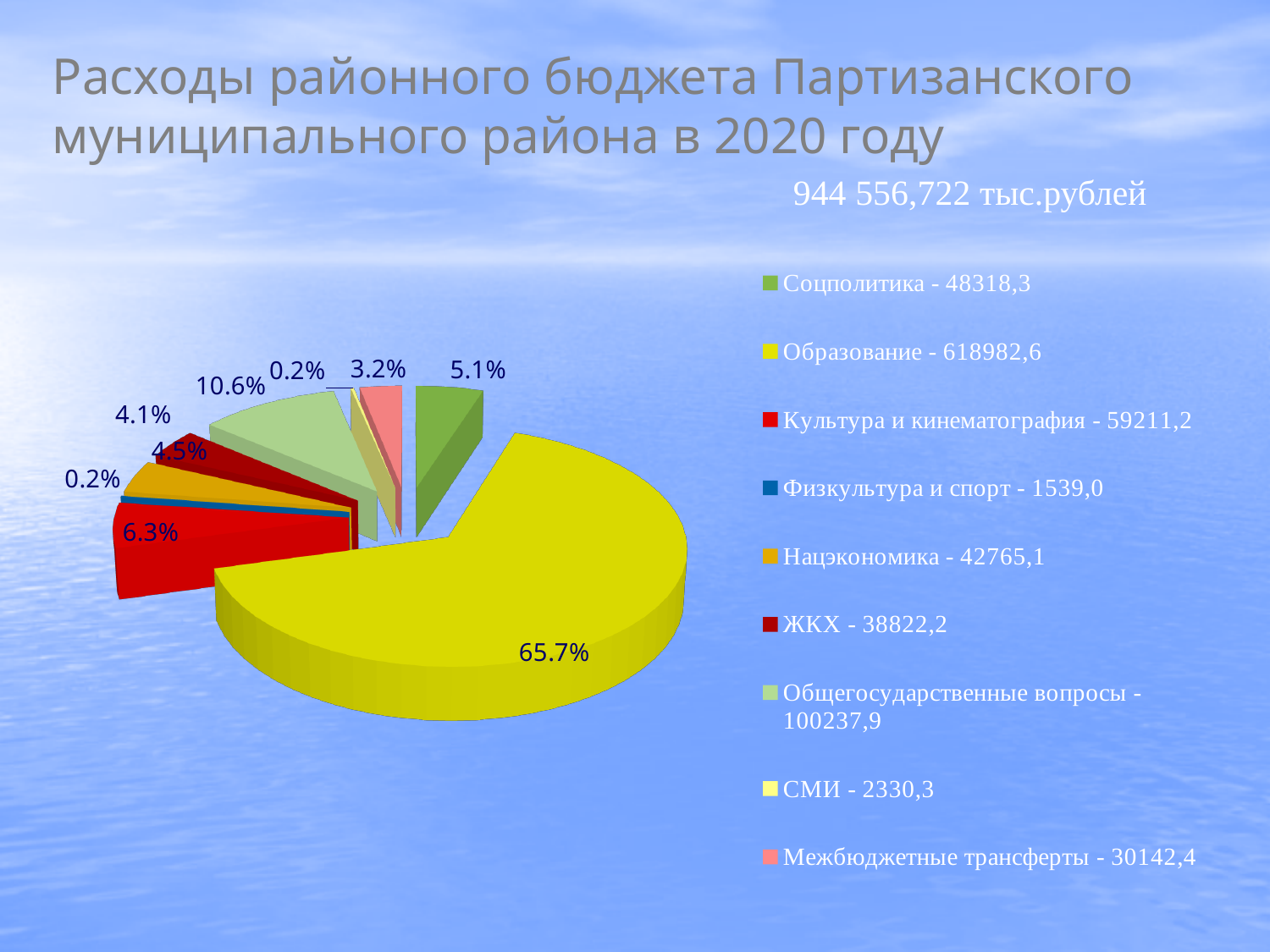
Which category has the smallest value according to the legend? Физкультура и спорт What value is given in the legend for Межбюджетные трансферты? 30142,4 What share of the pie does the Культура и кинематография slice represent? 6.3% What kind of chart is shown on the slide? pie chart What total amount in thousand rubles is stated on the slide for the budget expenditures? 944 556,722 тыс.рублей What is the difference between the legend values for Культура и кинематография and Соцполитика? 10892,9 How many categories does the legend of the pie chart list? 9 What share of the pie does the Общегосударственные вопросы slice represent? 10.6% What share of the pie does the Образование slice represent? 65.7% What value is given in the legend for Нацэкономика? 42765,1 Which is larger, the value for Соцполитика or the value for ЖКХ? Соцполитика Which category has the largest slice of the pie chart? Образование